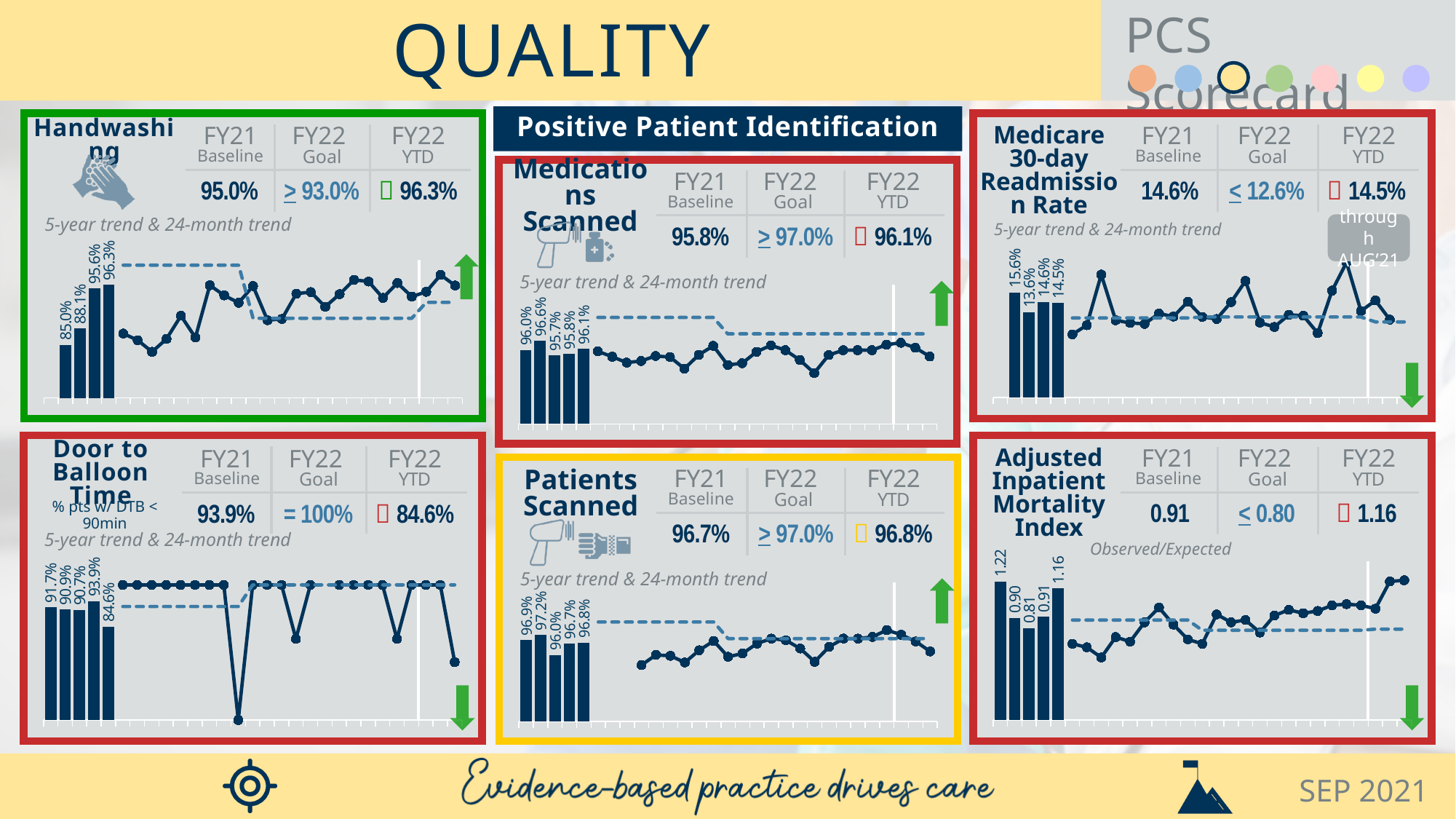
In the Medications Scanned chart, how many bars are shown? 5 In the Adjusted Inpatient Mortality Index chart, is the first bar (1.22) larger or smaller than the last bar (1.16)? larger In the Patients Scanned chart, which bar value is the highest? 97.2% In the Door to Balloon Time chart, what is the difference between the fourth bar (93.9%) and the fifth bar (84.6%)? 9.3% In the Medications Scanned chart, which bar value is the lowest? 95.7% In the Handwashing chart, what is the value of the first (leftmost) bar? 85.0% In the Adjusted Inpatient Mortality Index chart, which bar value is the lowest? 0.81 In the Handwashing chart, how many bars are shown in the 5-year trend? 4 In the Patients Scanned chart, what is the value of the third bar? 96.0% In the Door to Balloon Time chart, what is the value of the last (rightmost) bar? 84.6% In the Handwashing chart, what is the difference between the highest bar (96.3%) and the lowest bar (85.0%)? 11.3% In the Medicare 30-day Readmission Rate chart, which bar value is the highest? 15.6%